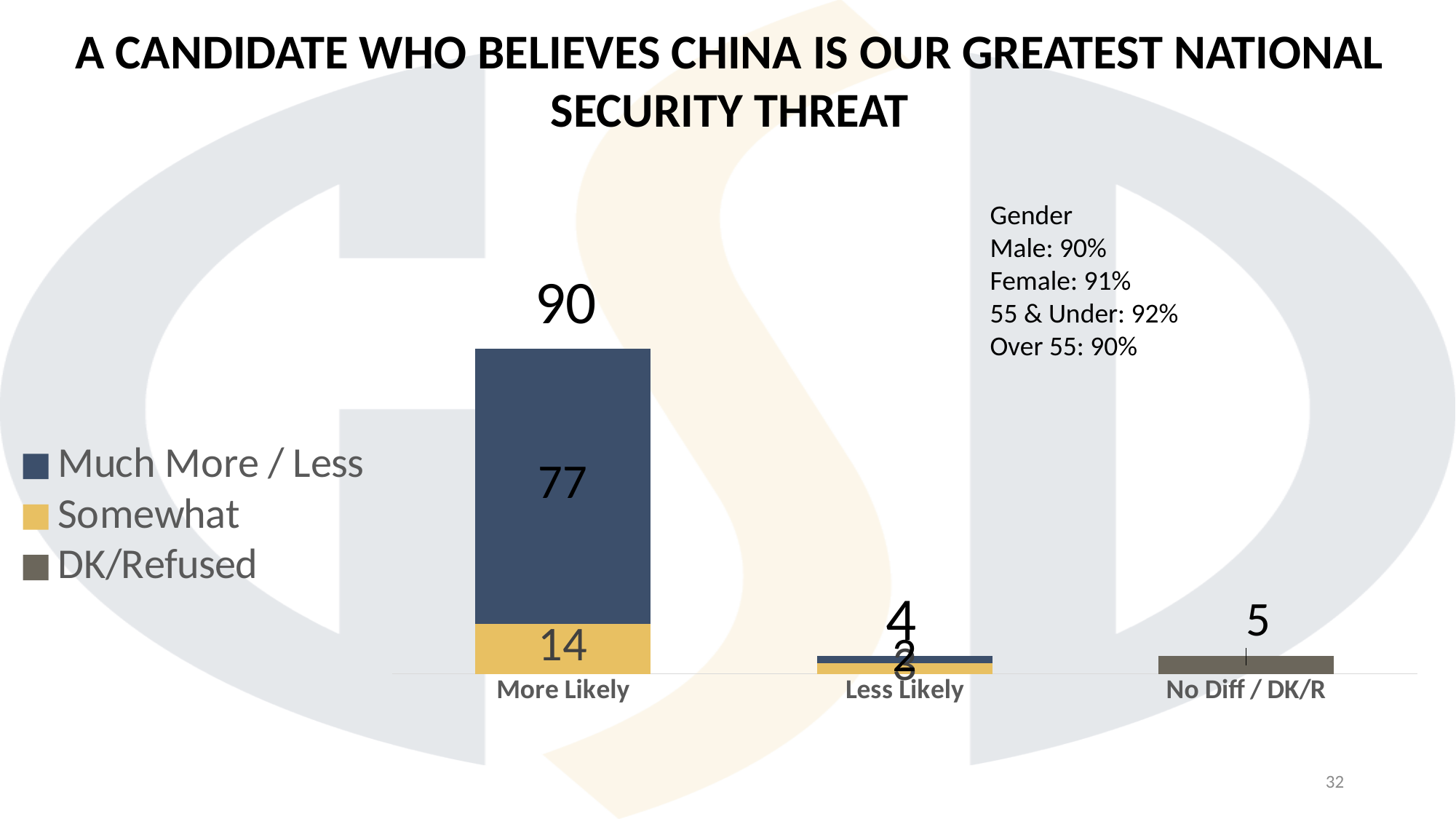
Which is larger, the total for More Likely or the value for No Diff / DK/R? More Likely What is the value for No Diff / DK/R? 5 Which category has the highest total? More Likely What kind of chart is shown on the slide? Stacked bar chart What is the Somewhat value for More Likely? 14 What is the total shown above the More Likely bar? 90 How many categories are shown on the x axis? 3 What is the difference between the Much More / Less and Somewhat values for More Likely? 63 What is the total shown above the Less Likely bar? 4 Which category has the lowest total? Less Likely How many series does the legend list? 3 What is the Much More / Less value for More Likely? 77